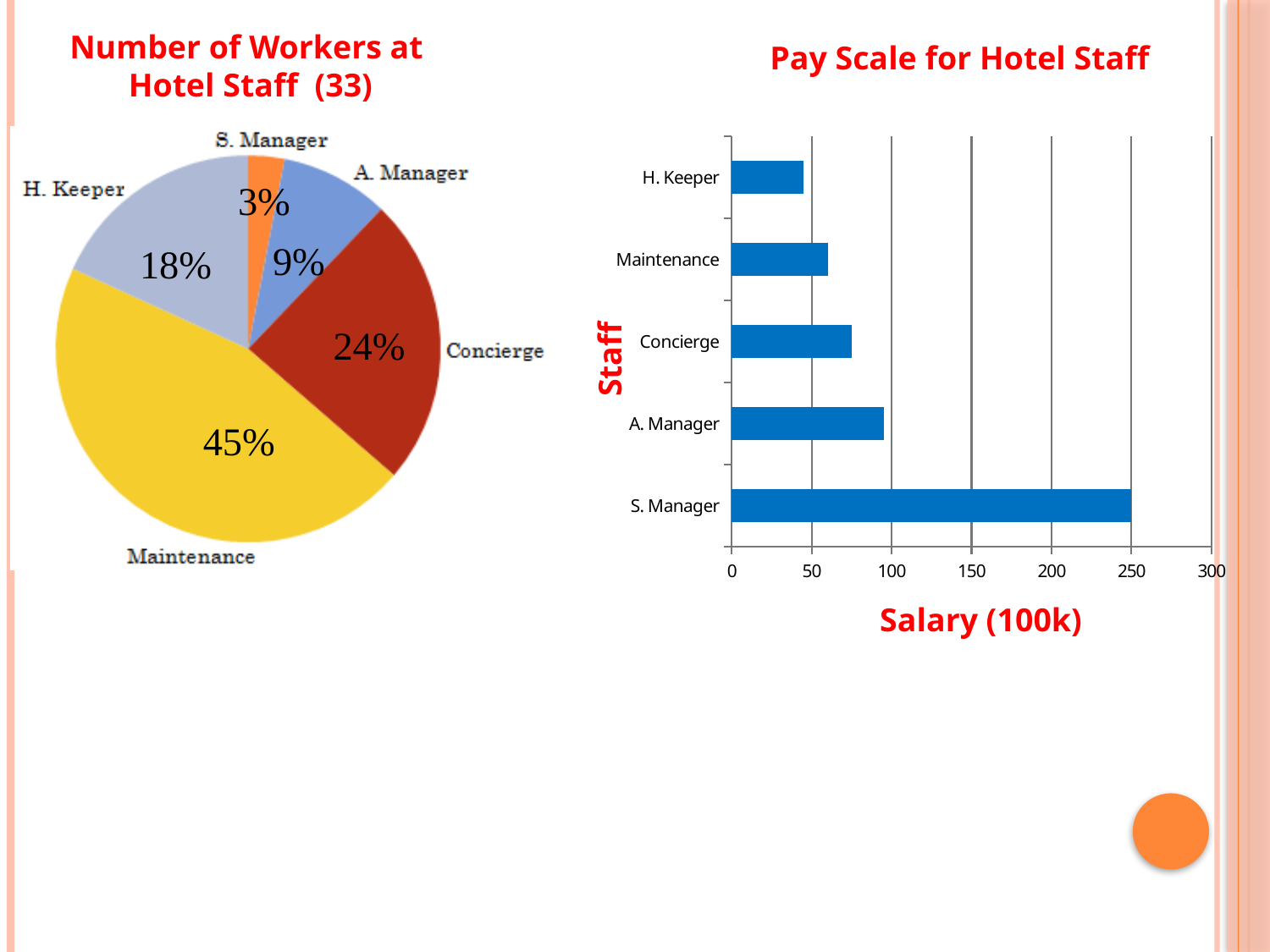
In the bar chart 'Pay Scale for Hotel Staff', which staff category has the lowest salary? H. Keeper In the bar chart 'Pay Scale for Hotel Staff', is the value for Concierge greater or less than 100? less In the pie chart 'Number of Workers at Hotel Staff (33)', what share of workers is Maintenance? 45% In the pie chart 'Number of Workers at Hotel Staff (33)', which category has the largest slice? Maintenance What is the x-axis label of the bar chart 'Pay Scale for Hotel Staff'? Salary (100k) In the pie chart 'Number of Workers at Hotel Staff (33)', what share of workers is S. Manager? 3% In the pie chart 'Number of Workers at Hotel Staff (33)', what is the difference in percentage points between H. Keeper and A. Manager? 9 How many slices does the pie chart 'Number of Workers at Hotel Staff (33)' have? 5 What kind of chart is 'Pay Scale for Hotel Staff'? Bar chart In the bar chart 'Pay Scale for Hotel Staff', what is the salary value for S. Manager? 250 In the pie chart 'Number of Workers at Hotel Staff (33)', what share of workers is Concierge? 24% In the pie chart 'Number of Workers at Hotel Staff (33)', which category has the smallest slice? S. Manager